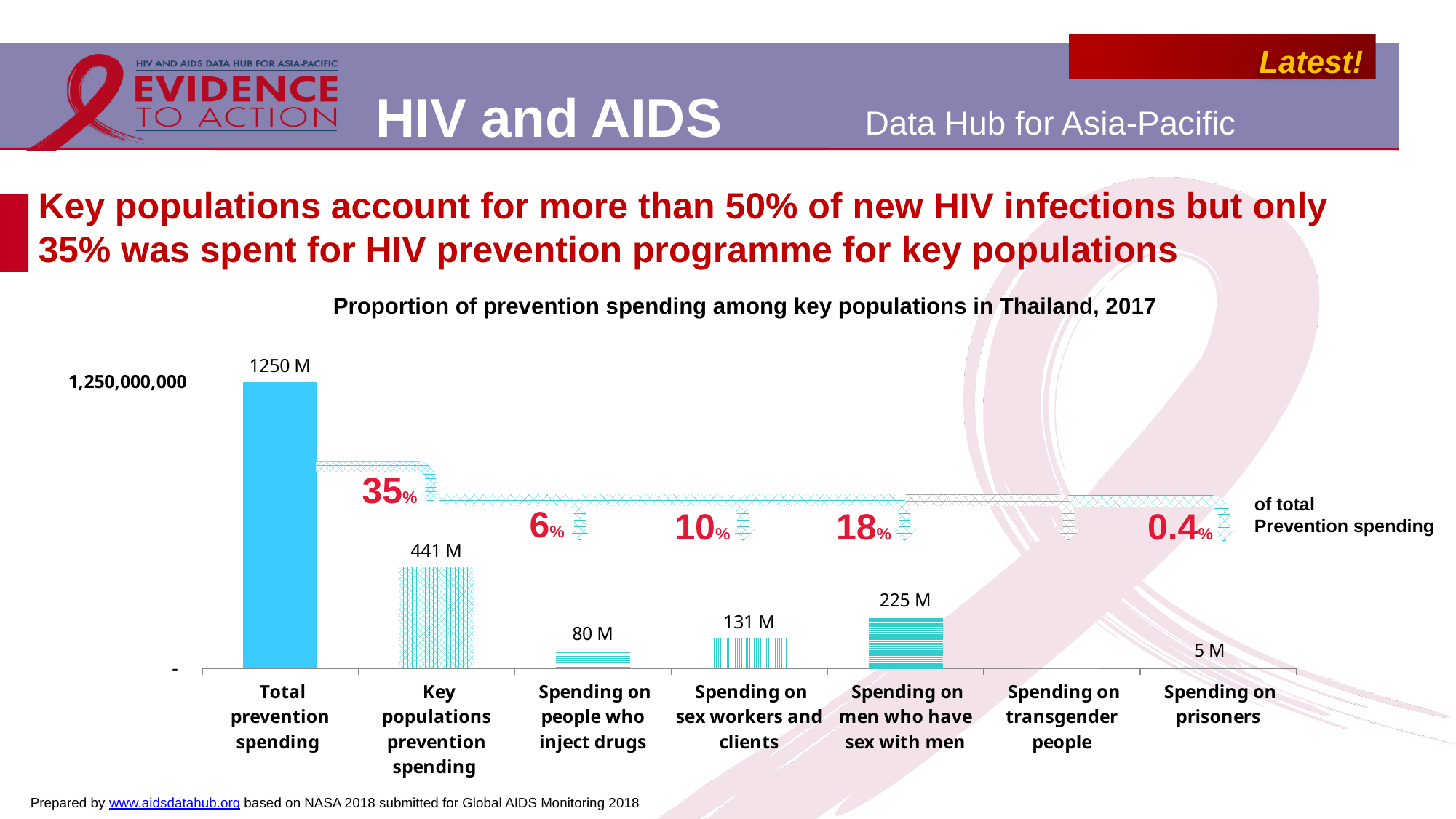
What is the value for Total prevention spending? 1250 M What is the value for Spending on prisoners? 5 M What is the title of the chart? Proportion of prevention spending among key populations in Thailand, 2017 Which is larger: Spending on sex workers and clients or Spending on people who inject drugs? Spending on sex workers and clients What percentage of total prevention spending is shown for Spending on sex workers and clients? 10% Which category has the highest value? Total prevention spending What kind of chart is this? Bar chart What is the value for Spending on men who have sex with men? 225 M What is the value for Key populations prevention spending? 441 M How many categories are shown on the x axis? 7 What is the difference between Spending on men who have sex with men and Spending on people who inject drugs? 145 M